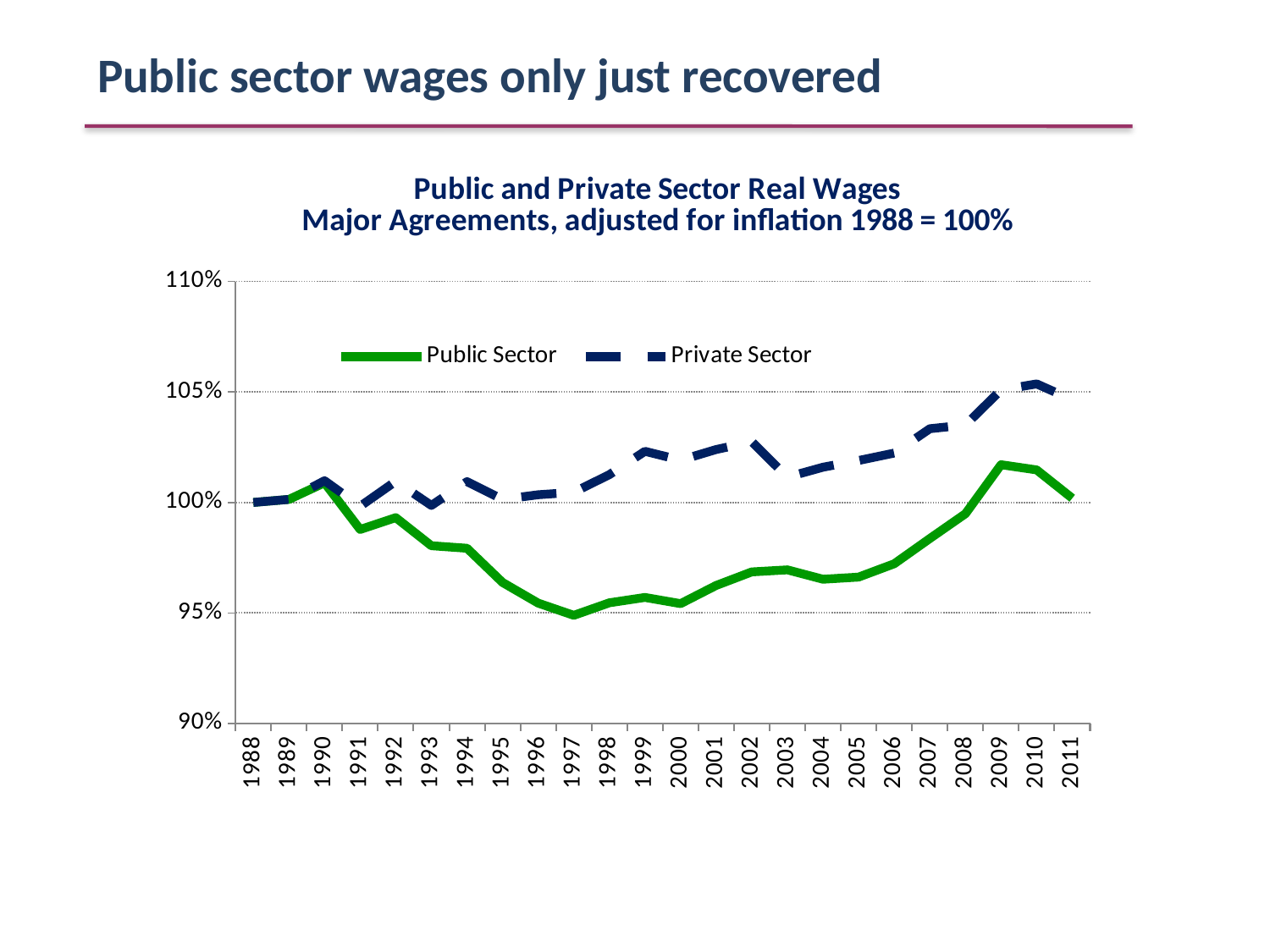
What is the value for the Public Sector in 1988? 100% How many years are plotted along the x axis? 24 Is the Public Sector value for 2004 greater or less than 100%? less How many series does the legend list? 2 Is the Public Sector value for 2009 greater or less than 100%? greater What kind of chart is shown on the slide? line chart Is the Private Sector value for 2007 greater or less than 100%? greater Does the Public Sector line rise or fall from 1990 to 1997? fall In which year is the Public Sector value lowest? 1997 In 2005, which series has the higher value, Public Sector or Private Sector? Private Sector Which series is drawn with a dashed line? Private Sector